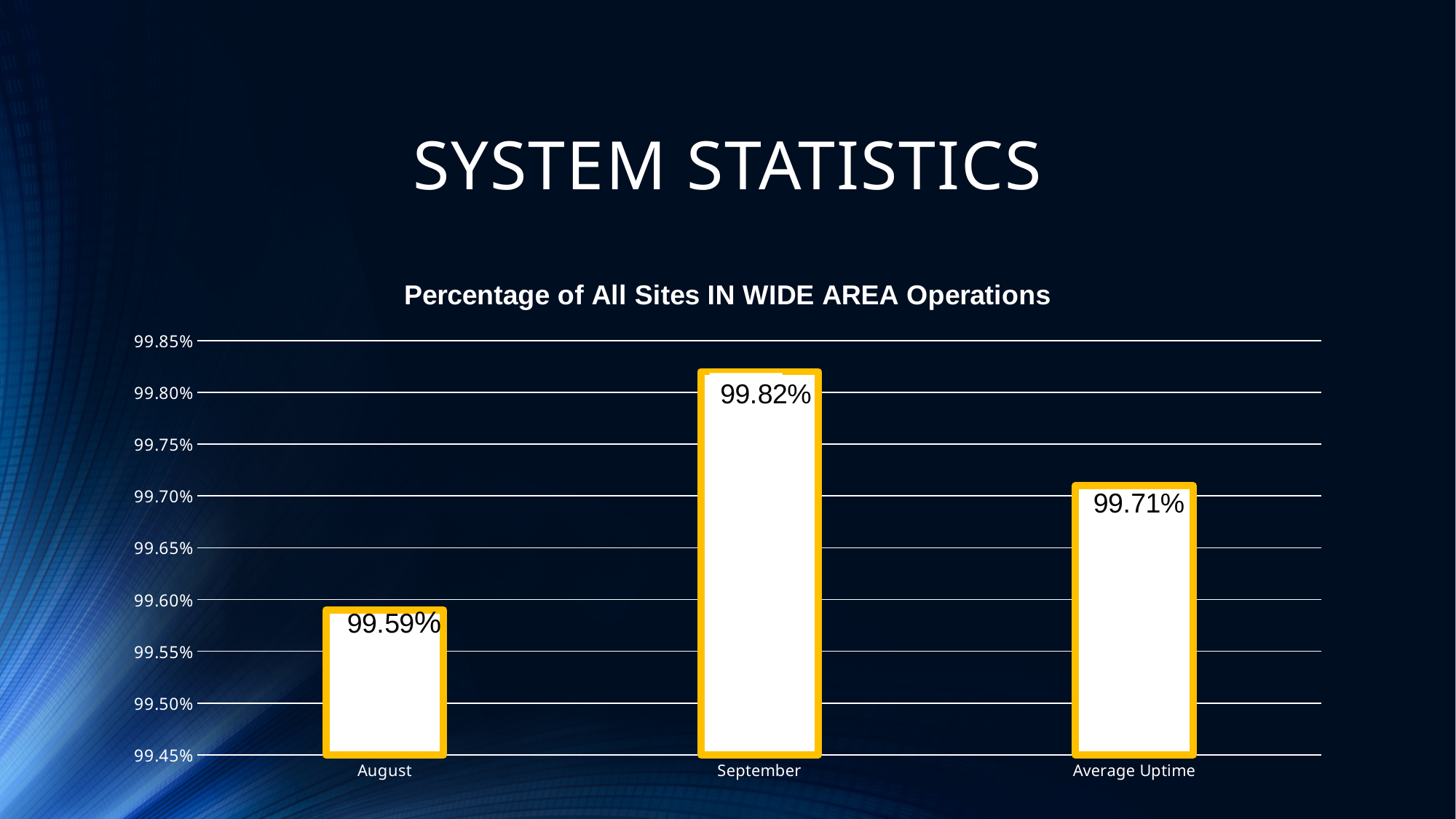
What is the value for September? 99.82% What is the value for August? 99.59% What is the title of the chart? Percentage of All Sites IN WIDE AREA Operations What is the difference between the September and August values? 0.23% How many categories are shown on the x axis? 3 What kind of chart is shown on the slide? bar chart Which category has the lowest value? August What is the value for Average Uptime? 99.71% Is the value for Average Uptime greater or less than 99.65%? greater Which category has the highest value? September Which is larger, the value for August or the value for Average Uptime? Average Uptime What is the difference between the September and Average Uptime values? 0.11%